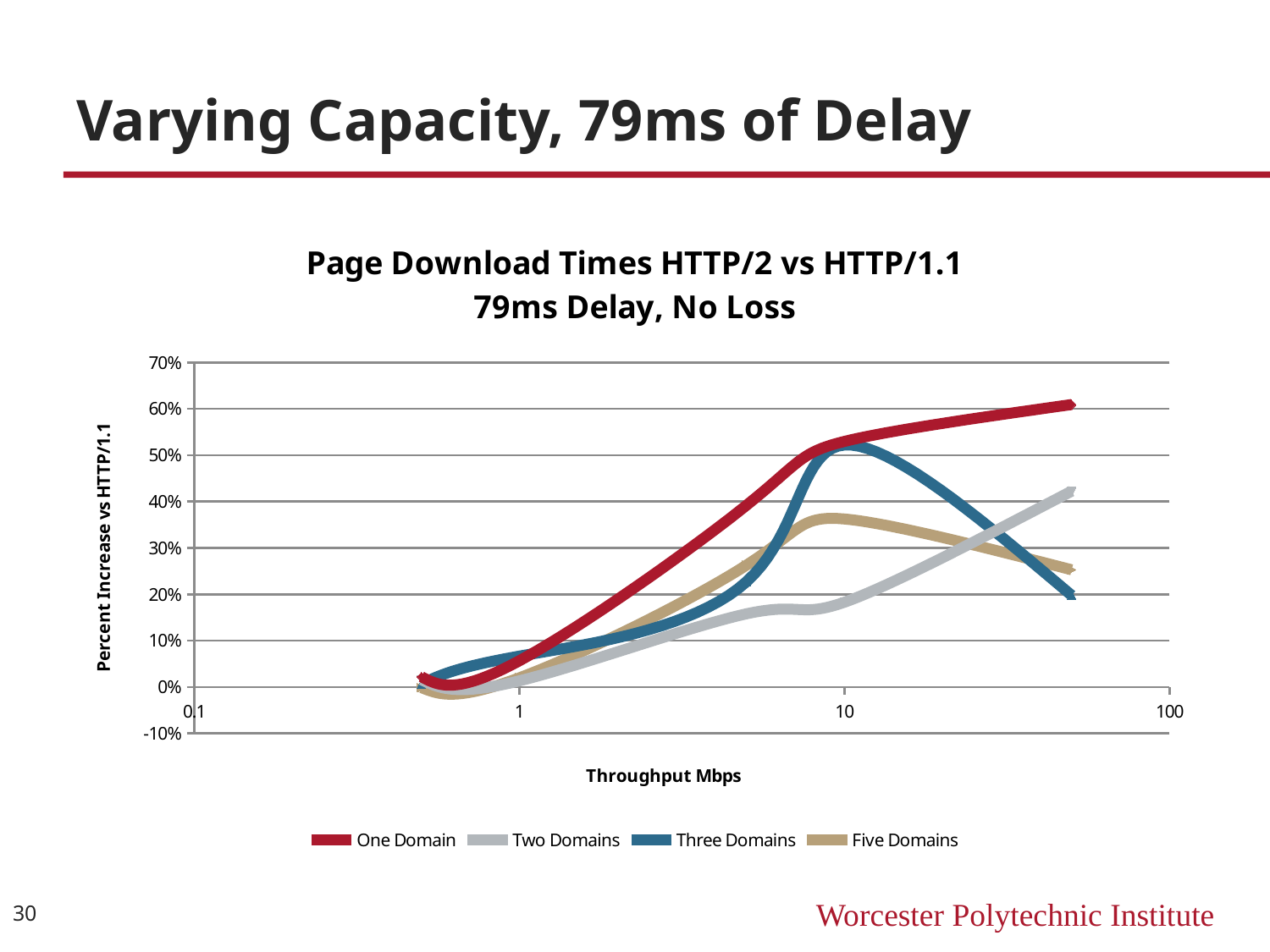
How many series does the legend list? 4 What is the label of the x axis? Throughput Mbps Is the value for Five Domains at 10 Mbps greater or less than 30%? greater Is the value for Two Domains at 10 Mbps greater or less than 20%? less Is the value for Five Domains at the right end of the chart greater or less than 30%? less Does the One Domain series rise or fall as throughput increases along the x axis? rise At 10 Mbps, which is larger: the value for One Domain or the value for Two Domains? One Domain Which series has the lowest value at the right end of the chart (around 50 Mbps)? Three Domains What kind of chart is shown on the slide? line chart What is the title of the chart? Page Download Times HTTP/2 vs HTTP/1.1 79ms Delay, No Loss Which series has the highest value at the right end of the chart (around 50 Mbps)? One Domain